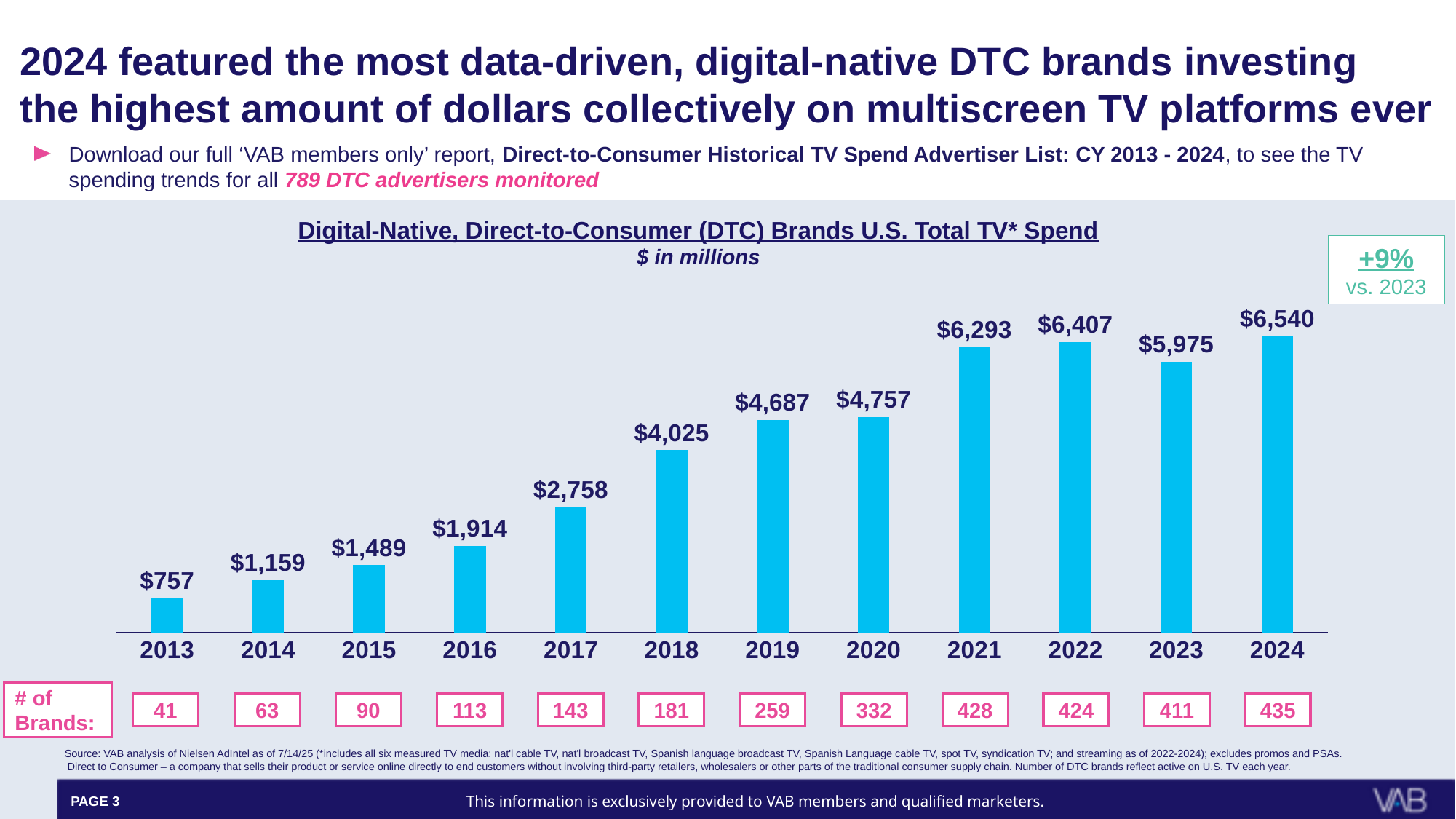
What is the difference in DTC brands' U.S. total TV spend between 2018 and 2017? $1,267 What was the DTC brands' U.S. total TV spend in 2013? $757 How many years are shown in the chart? 12 Does the DTC brands' U.S. total TV spend generally rise or fall from 2013 to 2024? Rise Which year has the lowest DTC brands' U.S. total TV spend? 2013 Which year had a higher DTC brands' U.S. total TV spend, 2022 or 2023? 2022 In what unit are the values in the chart expressed? $ in millions What is the difference in DTC brands' U.S. total TV spend between 2024 and 2023? $565 What kind of chart is used to show DTC brands' U.S. total TV spend? Bar chart What was the DTC brands' U.S. total TV spend in 2024? $6,540 Which year has the highest DTC brands' U.S. total TV spend? 2024 What was the DTC brands' U.S. total TV spend in 2018? $4,025